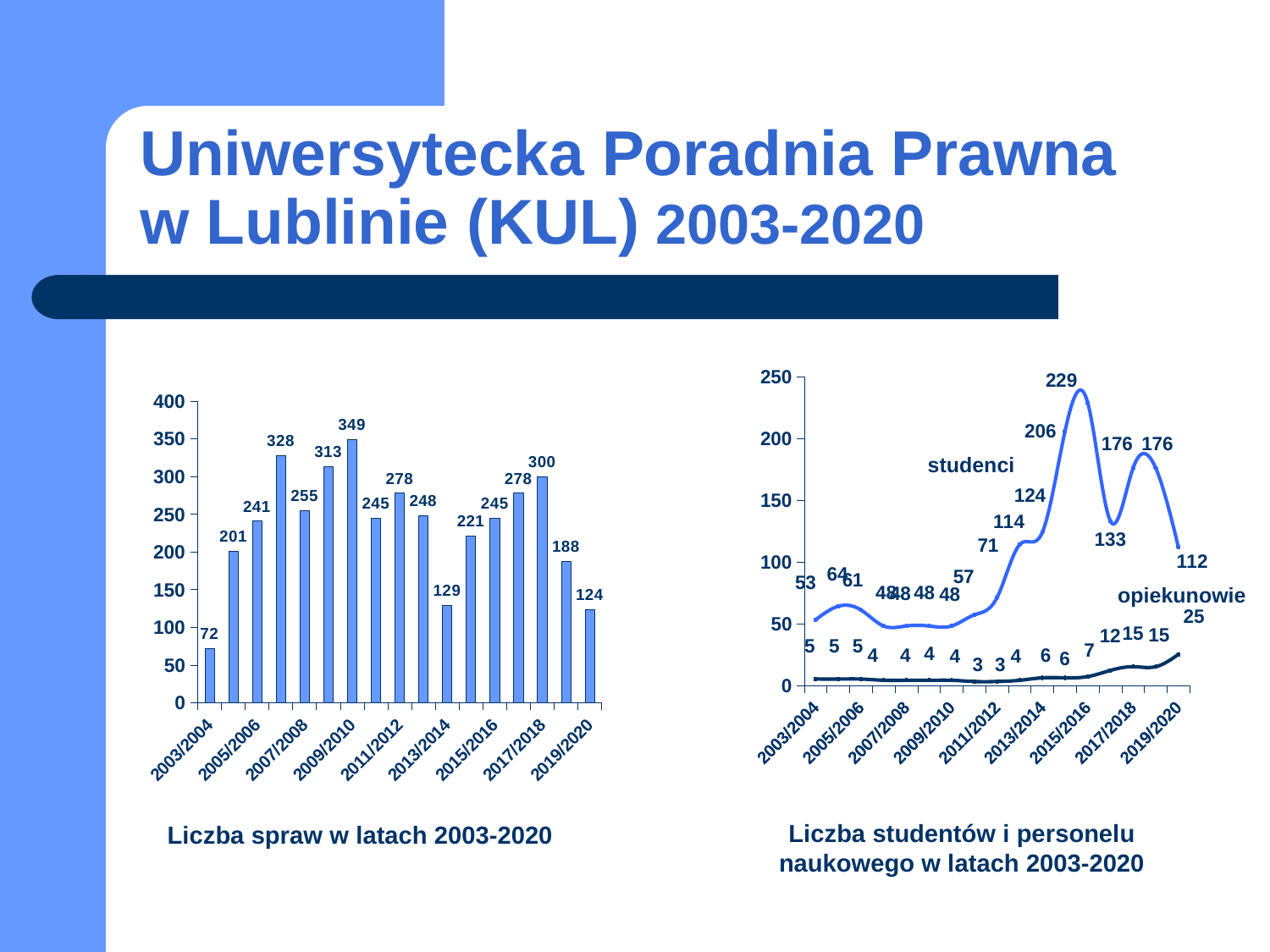
What kind of chart is the right chart, 'Liczba studentów i personelu naukowego w latach 2003-2020'? line chart In the right chart 'Liczba studentów i personelu naukowego w latach 2003-2020', what is the highest value of the 'studenci' series? 229 In the left chart 'Liczba spraw w latach 2003-2020', what is the value for 2009/2010? 349 In the right chart 'Liczba studentów i personelu naukowego w latach 2003-2020', what is the value of 'opiekunowie' for 2019/2020? 25 In the left chart 'Liczba spraw w latach 2003-2020', which year has the highest value? 2009/2010 In the right chart 'Liczba studentów i personelu naukowego w latach 2003-2020', what is the value of 'studenci' for 2019/2020? 112 In the left chart 'Liczba spraw w latach 2003-2020', which is larger, the value for 2005/2006 or for 2007/2008? 2007/2008 What kind of chart is the left chart, 'Liczba spraw w latach 2003-2020'? bar chart How many bars are plotted in the left chart 'Liczba spraw w latach 2003-2020'? 17 In the left chart 'Liczba spraw w latach 2003-2020', what is the difference between the values for 2017/2018 and 2019/2020? 176 In the left chart 'Liczba spraw w latach 2003-2020', which year has the lowest value? 2003/2004 How many series are plotted in the right chart 'Liczba studentów i personelu naukowego w latach 2003-2020'? 2